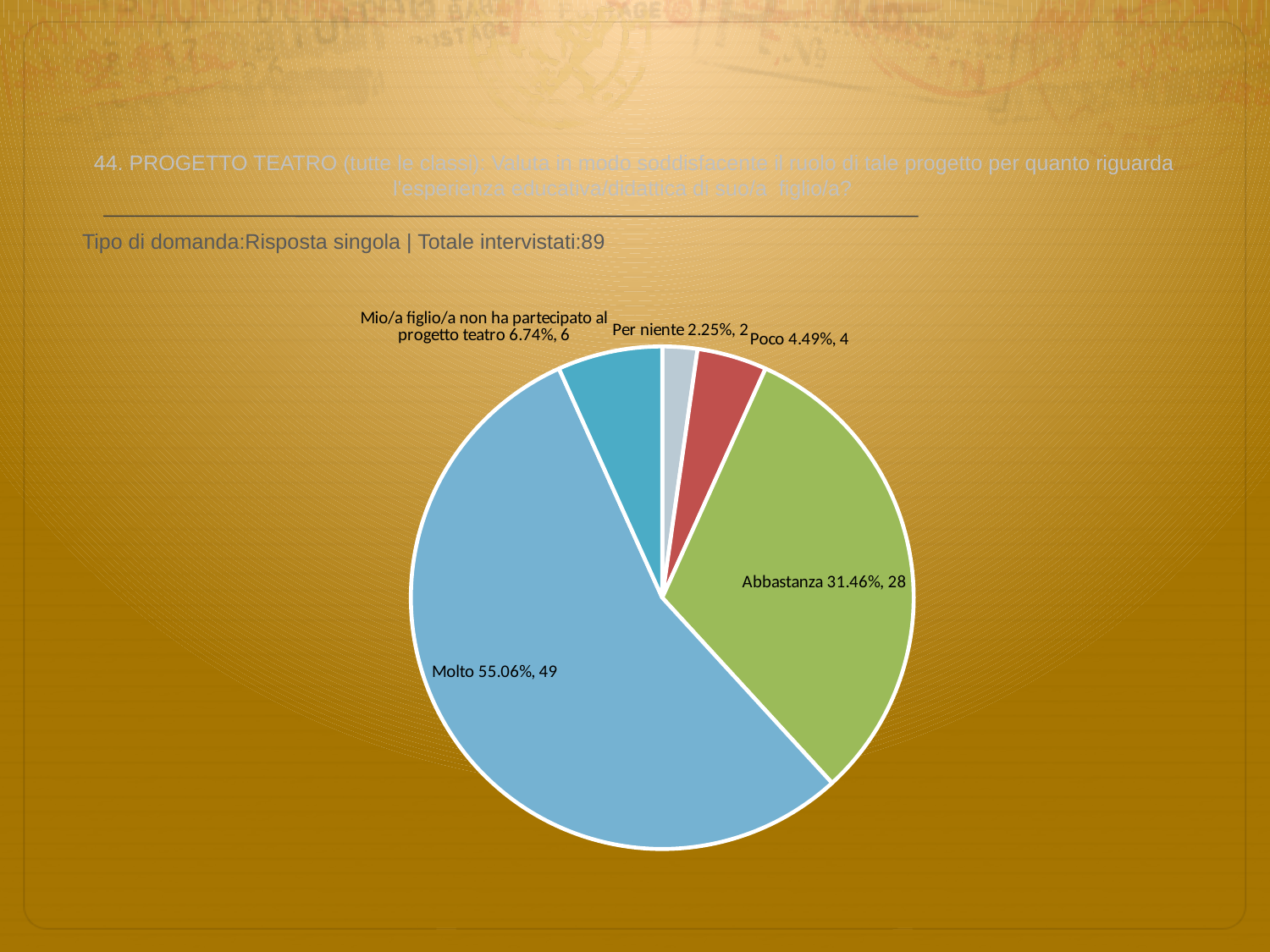
Which category has the largest slice of the pie? Molto What is the count shown for "Mio/a figlio/a non ha partecipato al progetto teatro"? 6 Which category has the smallest slice of the pie? Per niente Which has more respondents, "Poco" or "Mio/a figlio/a non ha partecipato al progetto teatro"? Mio/a figlio/a non ha partecipato al progetto teatro How many respondents answered "Abbastanza"? 28 What percentage of the pie does the "Molto" slice represent? 55.06% How many slices does the pie chart have? 5 What percentage is shown for "Poco"? 4.49% What is the difference in respondent counts between "Molto" and "Abbastanza"? 21 How many respondents answered "Per niente"? 2 What colour is the "Abbastanza" slice? green What kind of chart is shown on the slide? pie chart